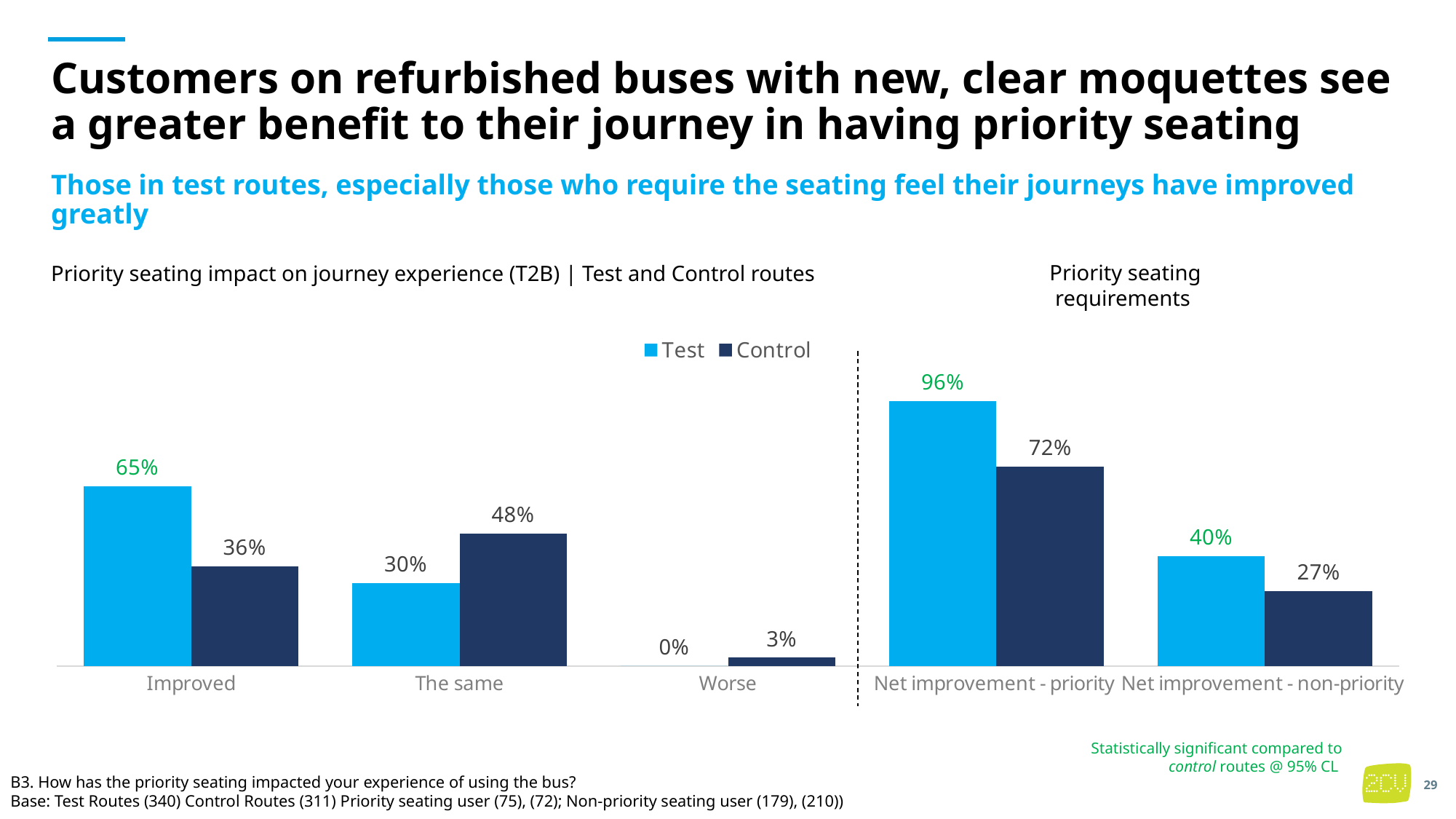
What is the difference between the Test and Control values for Net improvement - priority? 24% What is the Test value for Improved? 65% What is the Control value for The same? 48% What is the difference between the Test and Control values for Improved? 29% For The same, which is larger, the Test value or the Control value? Control How many series does the legend list? 2 What is the Test value for Net improvement - priority? 96% What kind of chart is shown on the slide? Bar chart How many categories are shown on the x axis? 5 Which category has the highest Test value? Net improvement - priority What is the Control value for Net improvement - non-priority? 27% Which category has the lowest Control value? Worse